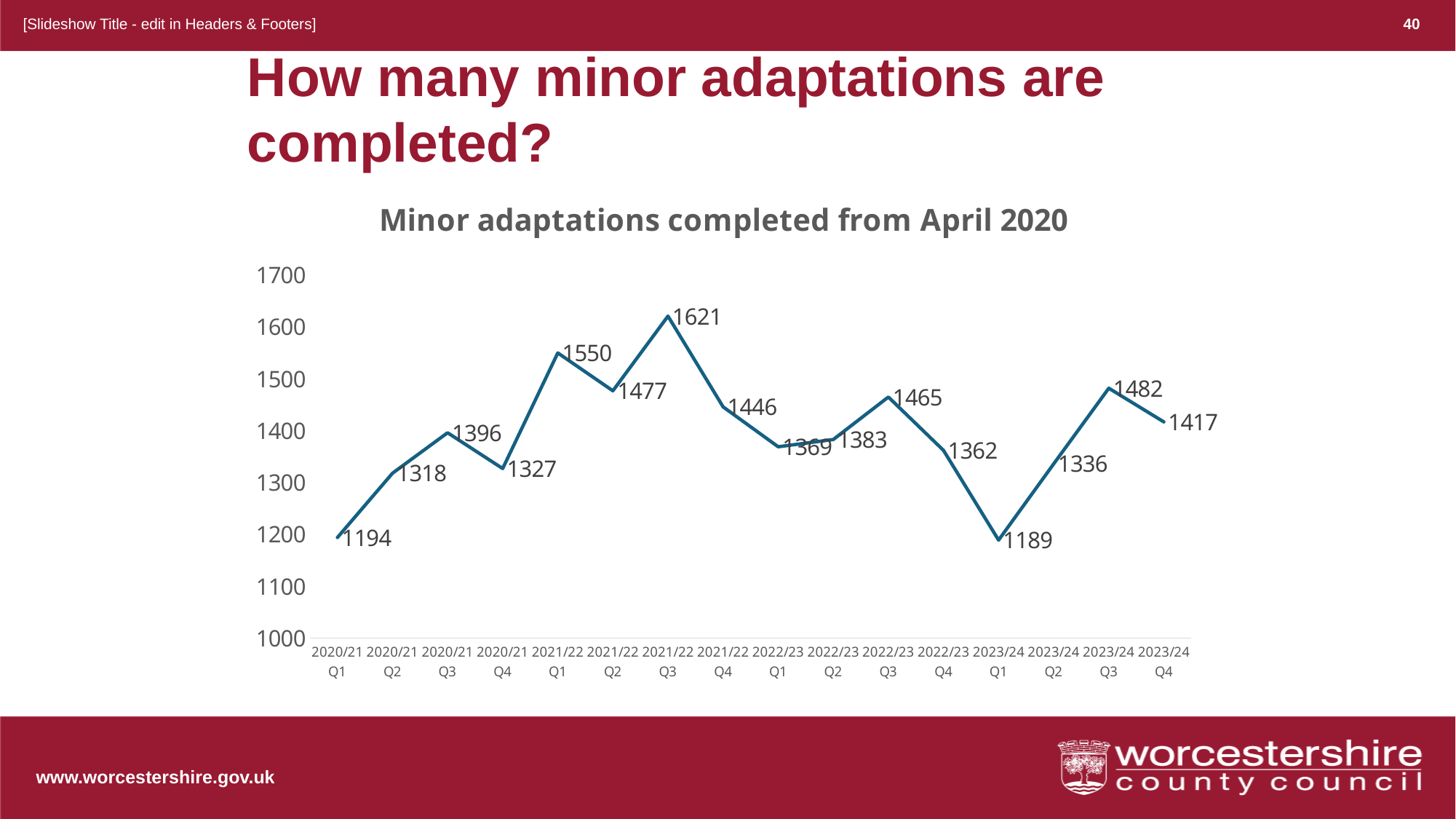
Which quarter has the highest number of minor adaptations completed? 2021/22 Q3 How many minor adaptations were completed in 2021/22 Q3? 1621 What is the title of the chart? Minor adaptations completed from April 2020 Is the value for 2022/23 Q3 greater or less than 1400? greater What type of chart is shown on the slide? Line chart Does the line rise or fall between 2023/24 Q1 and 2023/24 Q3? Rises What is the value for 2023/24 Q4? 1417 Which quarter has the lowest number of minor adaptations completed? 2023/24 Q1 How many data points are plotted on the chart? 16 What is the value for 2020/21 Q1? 1194 What is the difference between the values for 2021/22 Q3 and 2023/24 Q1? 432 Which is larger, the value for 2021/22 Q1 or the value for 2023/24 Q3? 2021/22 Q1